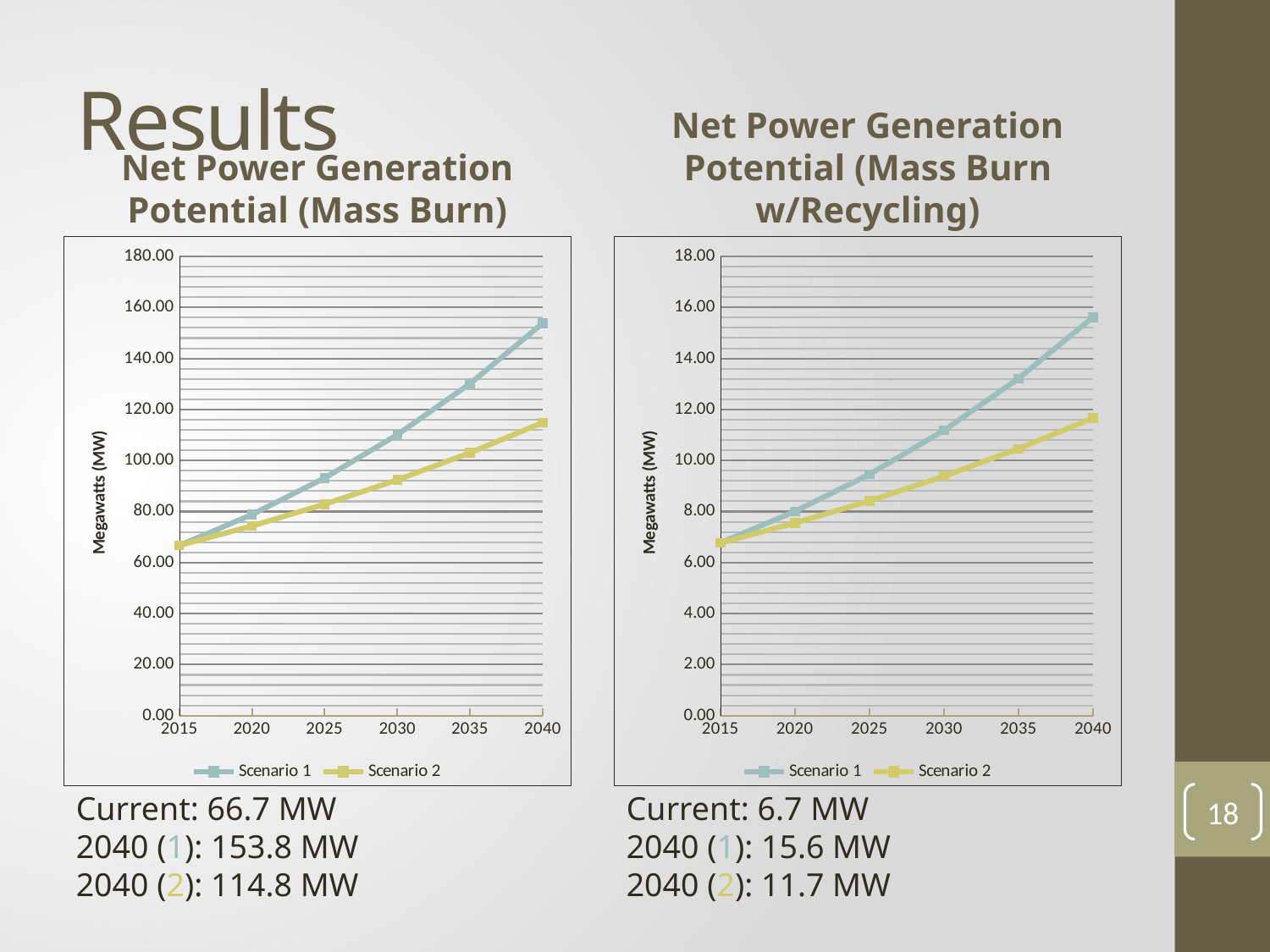
In the 'Net Power Generation Potential (Mass Burn)' chart, is the Scenario 1 value for 2030 greater or less than 100.00? greater In the 'Net Power Generation Potential (Mass Burn)' chart, do the Scenario 1 values rise or fall from 2015 to 2040? rise In the 'Net Power Generation Potential (Mass Burn)' chart, is the Scenario 2 value for 2025 greater or less than 100.00? less In the 'Net Power Generation Potential (Mass Burn)' chart, how many years are marked on the x axis? 6 How many series does the legend of the 'Net Power Generation Potential (Mass Burn w/Recycling)' chart list? 2 According to the text under the 'Net Power Generation Potential (Mass Burn w/Recycling)' chart, what is the current value? 6.7 MW According to the text under the 'Net Power Generation Potential (Mass Burn)' chart, what is the 2040 value for Scenario 1? 153.8 MW In the 'Net Power Generation Potential (Mass Burn w/Recycling)' chart, is the Scenario 1 value for 2035 greater or less than 12.00? greater What kind of chart is the 'Net Power Generation Potential (Mass Burn)' chart? line chart In the 'Net Power Generation Potential (Mass Burn w/Recycling)' chart, which scenario is lower in 2040? Scenario 2 What is the y-axis label on the 'Net Power Generation Potential (Mass Burn w/Recycling)' chart? Megawatts (MW) In the 'Net Power Generation Potential (Mass Burn)' chart, which scenario is higher in 2040? Scenario 1